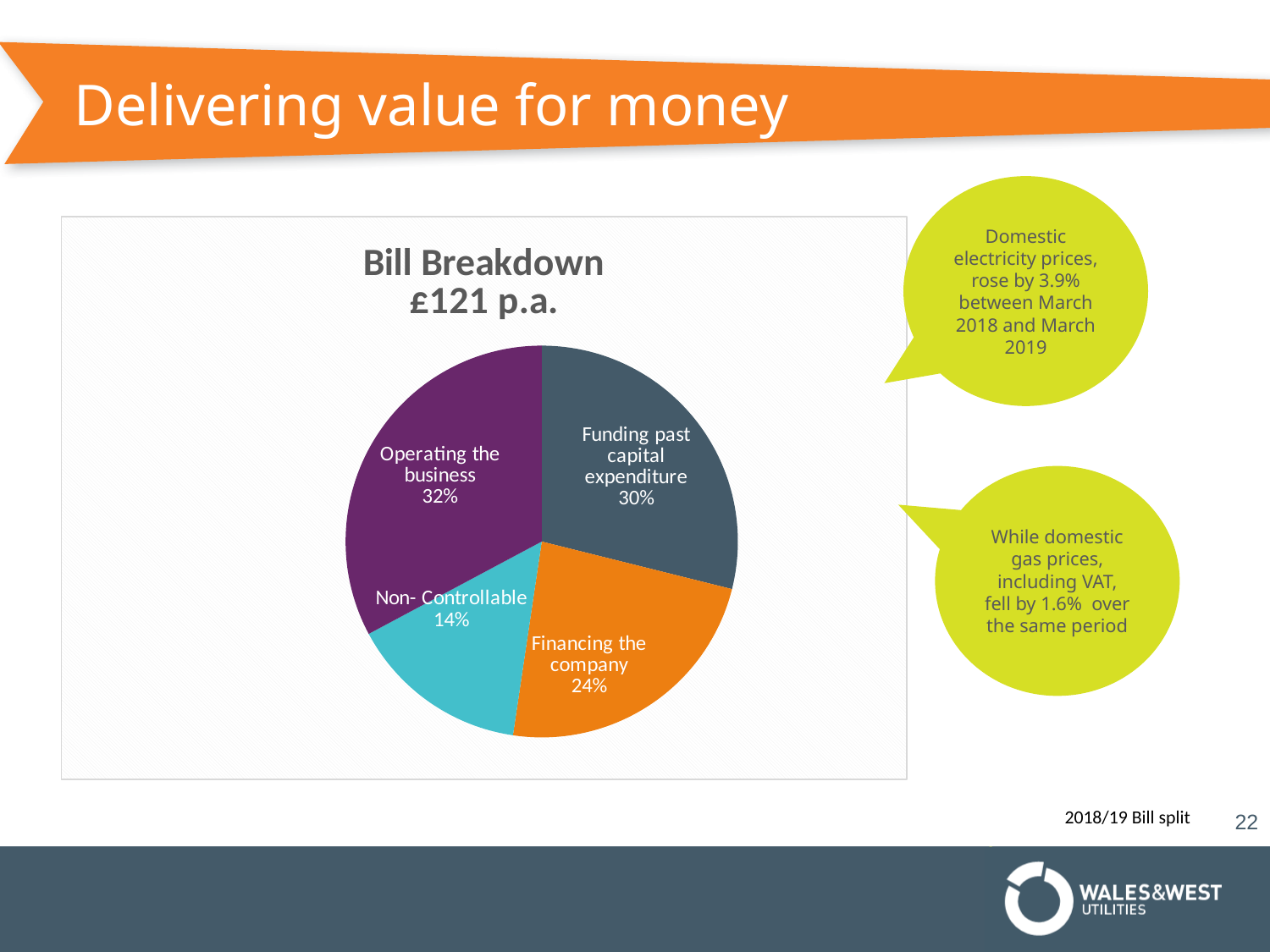
What kind of chart is shown on the slide? Pie chart What share of the bill is Operating the business? 32% What colour is the Financing the company slice? Orange What is the title of the chart? Bill Breakdown £121 p.a. What share of the bill is Funding past capital expenditure? 30% What is the difference in percentage points between Operating the business and Non-Controllable? 18 percentage points Which slice of the pie is the largest? Operating the business Which slice of the pie is the smallest? Non-Controllable What share of the bill is Non-Controllable? 14% Which is larger, Financing the company or Funding past capital expenditure? Funding past capital expenditure How many slices does the pie chart have? 4 What share of the bill is Financing the company? 24%